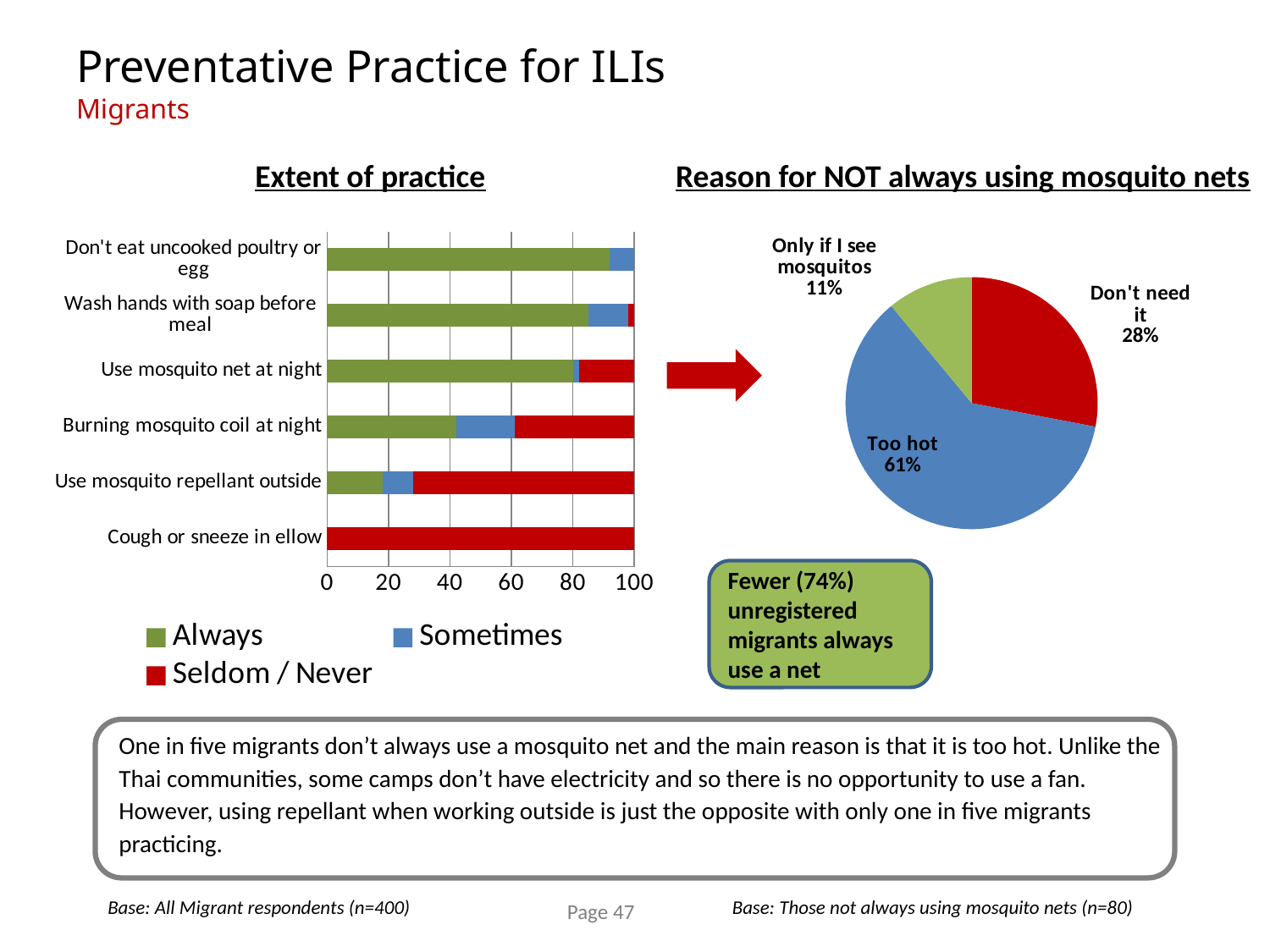
What kind of chart is the 'Reason for NOT always using mosquito nets' chart? pie chart In the 'Extent of practice' chart, which category has the highest 'Always' value? Don't eat uncooked poultry or egg In the 'Reason for NOT always using mosquito nets' pie chart, which reason has the smallest share? Only if I see mosquitos In the 'Extent of practice' chart, is the 'Always' value for 'Don't eat uncooked poultry or egg' greater or less than 80? greater In the 'Reason for NOT always using mosquito nets' pie chart, what is the difference in percentage points between 'Too hot' and 'Don't need it'? 33 In the 'Reason for NOT always using mosquito nets' pie chart, what share is 'Too hot'? 61% In the 'Extent of practice' chart, how many practice categories are shown? 6 In the 'Extent of practice' chart, which category has the lowest 'Always' value? Cough or sneeze in ellow What kind of chart is the 'Extent of practice' chart? bar chart In the 'Extent of practice' chart, which is larger: the 'Always' value for 'Wash hands with soap before meal' or for 'Burning mosquito coil at night'? Wash hands with soap before meal In the 'Extent of practice' chart, is the 'Always' value for 'Use mosquito repellant outside' greater or less than 40? less In the 'Extent of practice' chart, how many series does the legend list? 3